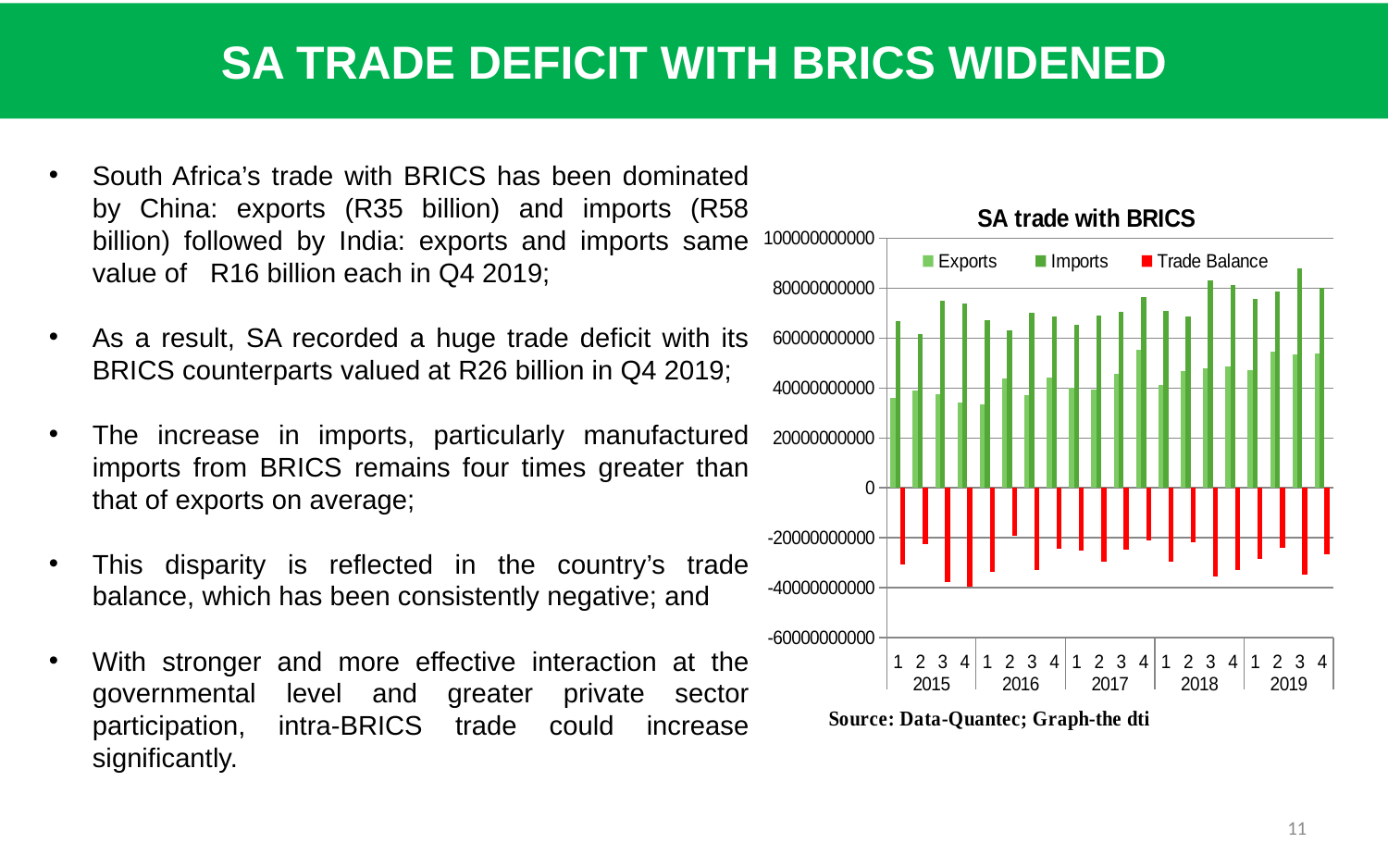
Which series in the 'SA trade with BRICS' chart is shown in red? Trade Balance In the 'SA trade with BRICS' chart, is the Imports value for quarter 4 of 2017 greater or less than 60000000000? greater How many series does the legend of the 'SA trade with BRICS' chart list? 3 In the 'SA trade with BRICS' chart, is the Imports value for quarter 3 of 2019 greater or less than 80000000000? greater How many quarters are plotted along the x axis of the 'SA trade with BRICS' chart? 20 In the 'SA trade with BRICS' chart, which is larger, Exports in quarter 1 of 2018 or Exports in quarter 4 of 2015? Quarter 1 of 2018 In the 'SA trade with BRICS' chart, is the Exports value for quarter 1 of 2015 greater or less than 40000000000? less In the 'SA trade with BRICS' chart, are the Trade Balance values positive or negative across all quarters shown? Negative In the 'SA trade with BRICS' chart, which is larger in quarter 4 of 2019, Exports or Imports? Imports Which years are covered on the x axis of the 'SA trade with BRICS' chart? 2015 to 2019 What kind of chart is 'SA trade with BRICS'? Bar chart